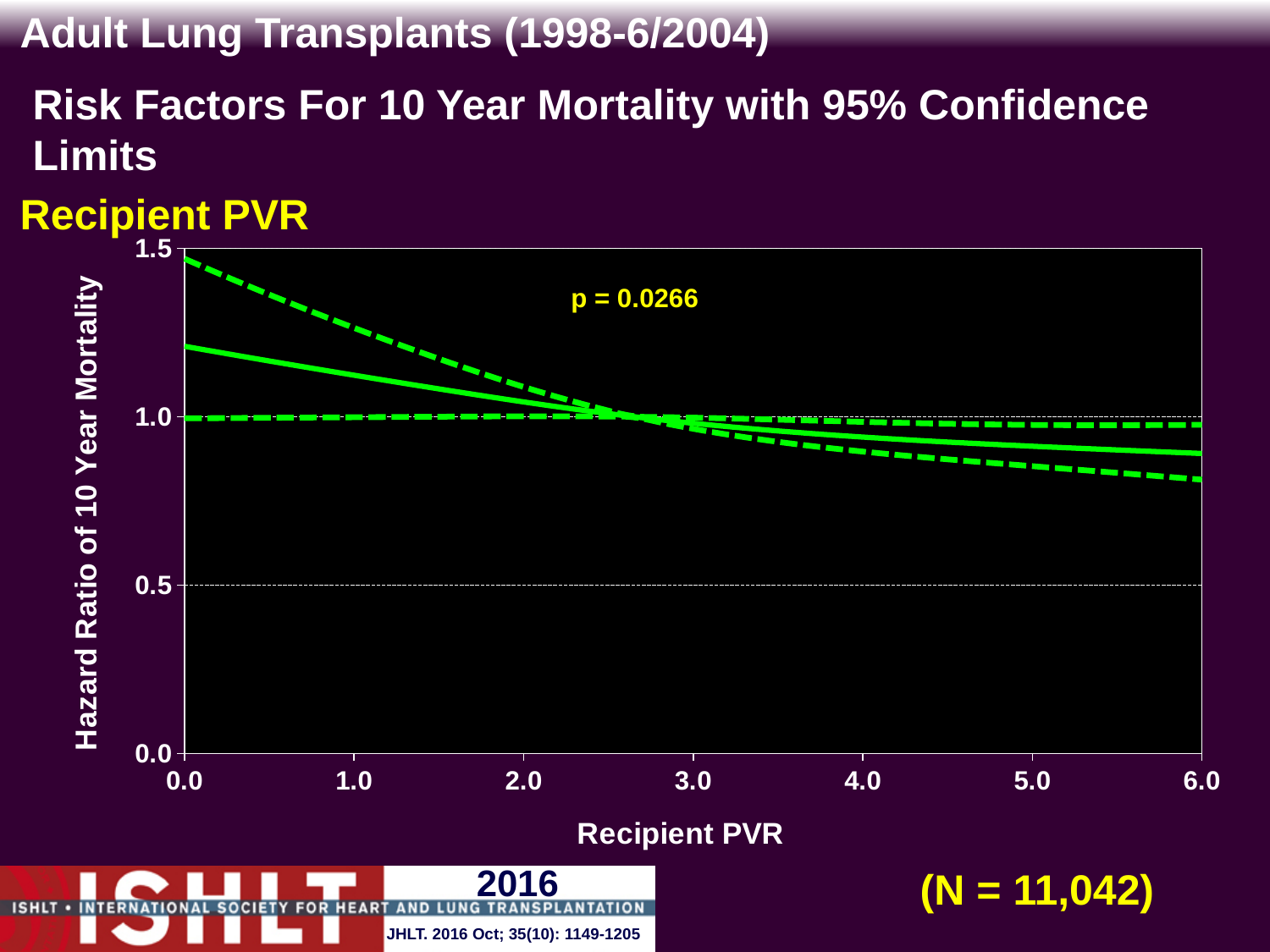
What is the highest value shown on the y axis of the chart? 1.5 At a Recipient PVR of 6.0, is the solid hazard ratio line greater or less than 1.0? less At a Recipient PVR of 0.0, is the upper dashed confidence limit greater or less than 1.5? less How many lines are plotted on the chart? 3 Does the solid hazard ratio line rise or fall as Recipient PVR increases from 0.0 to 6.0? fall What sample size (N) is shown on the slide? N = 11,042 At a Recipient PVR of 0.0, is the solid hazard ratio line greater or less than 1.0? greater Is the solid hazard ratio line higher at a Recipient PVR of 0.0 or at 6.0? 0.0 What kind of chart is shown on the slide? line chart What p-value is printed on the chart? p = 0.0266 At a Recipient PVR of 0.0, which is higher: the upper dashed confidence limit or the solid hazard ratio line? the upper dashed confidence limit